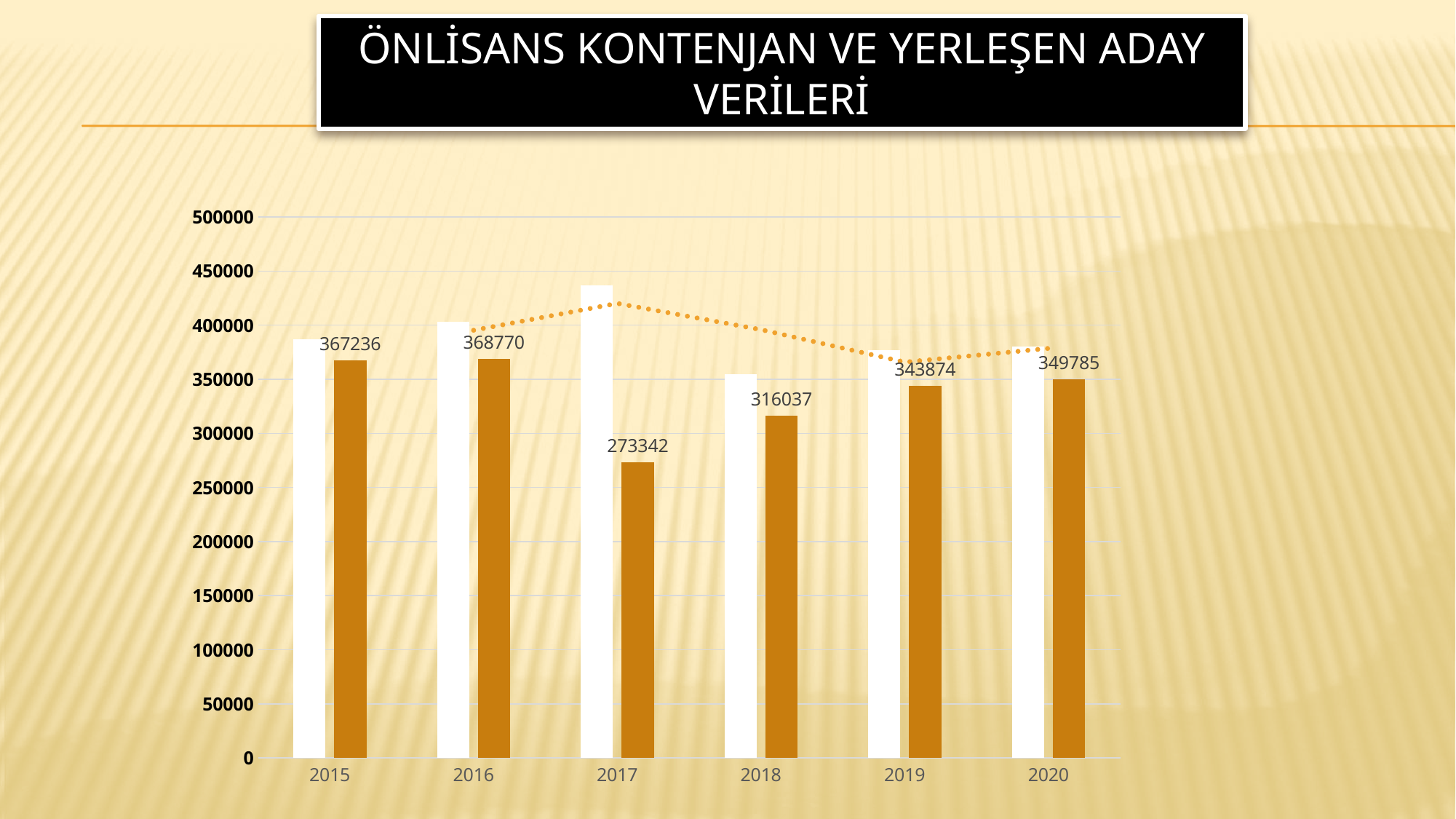
Which year has the lowest value among the orange (labelled) bars? 2017 Is the value of the white bar for 2018 greater or less than 400000? less What is the difference between the orange bar values for 2016 and 2015? 1534 What is the value of the orange (labelled) bar for 2020? 349785 What is the value of the orange (labelled) bar for 2017? 273342 Which is larger, the orange bar value for 2018 or for 2019? 2019 What kind of chart is shown on the slide? Bar chart What is the difference between the orange bar values for 2020 and 2019? 5911 Which year has the highest value among the orange (labelled) bars? 2016 Is the value of the white bar for 2017 greater or less than 400000? greater How many years are shown on the x axis? 6 What is the value of the orange (labelled) bar for 2018? 316037